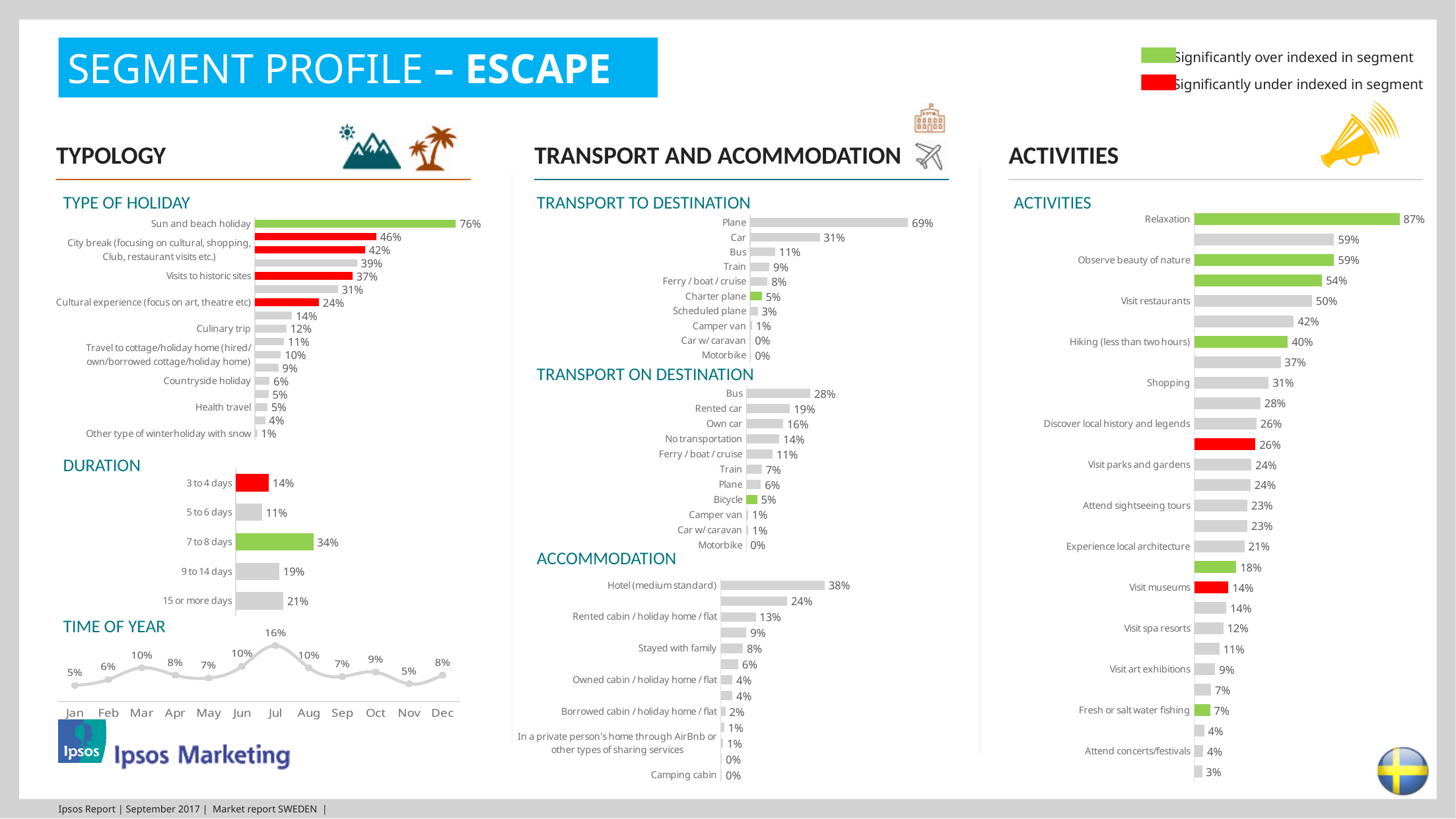
What kind of chart is the TIME OF YEAR chart? Line chart In the DURATION chart, which duration category has the highest value? 7 to 8 days In the TRANSPORT ON DESTINATION chart, which is larger, Bus or Rented car? Bus In the TIME OF YEAR chart, which month has the highest value? Jul In the ACTIVITIES chart, what is the difference between the values for Visit restaurants and Shopping? 19% In the DURATION chart, what is the difference between the values for 7 to 8 days and 3 to 4 days? 20% In the TIME OF YEAR chart, how many months are plotted? 12 In the ACTIVITIES chart, what is the value for Relaxation? 87% In the ACCOMMODATION chart, what is the value for Hotel (medium standard)? 38% In the TRANSPORT TO DESTINATION chart, what is the value for Plane? 69% In the TYPE OF HOLIDAY chart, what is the value for Sun and beach holiday? 76% In the TYPE OF HOLIDAY chart, what colour is the bar for Sun and beach holiday? Green